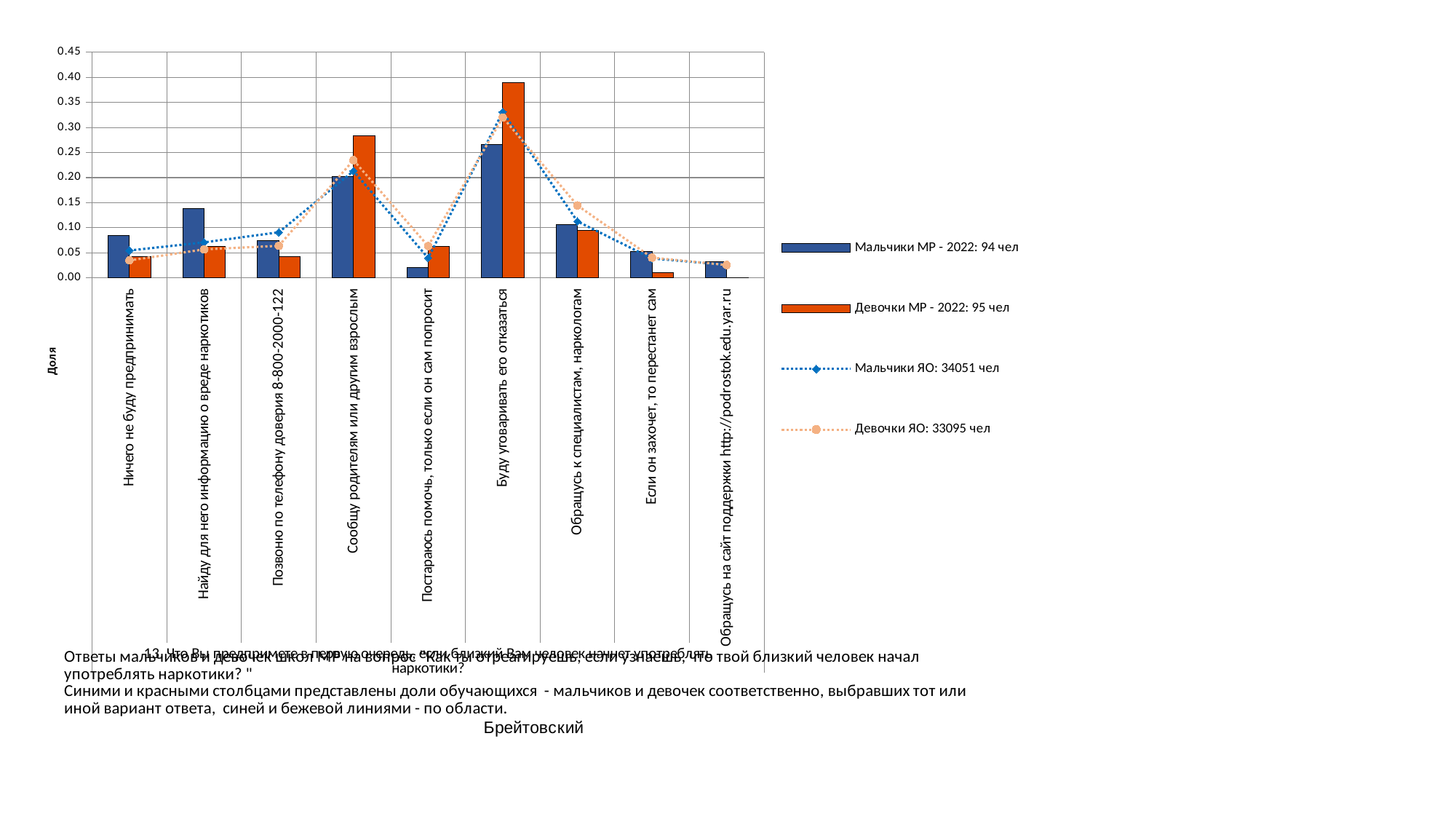
For 'Сообщу родителям или другим взрослым', which is larger: the Мальчики МР - 2022 bar or the Девочки МР - 2022 bar? Девочки МР - 2022 Is the Девочки МР - 2022 value for 'Ничего не буду предпринимать' greater or less than 0.05? less How many answer categories are shown on the x axis of the chart? 9 Is the Девочки МР - 2022 value for 'Буду уговаривать его отказаться' greater or less than 0.35? greater How many respondents does the legend give for the Мальчики ЯО series? 34051 чел Is the Мальчики МР - 2022 value for 'Найду для него информацию о вреде наркотиков' greater or less than 0.10? greater How many series does the chart legend list? 4 Which category has the highest value for the Мальчики МР - 2022 series? Буду уговаривать его отказаться What kind of chart is used to plot the Мальчики МР - 2022 and Девочки МР - 2022 series? bar chart Which category has the lowest value for the Мальчики МР - 2022 series? Постараюсь помочь, только если он сам попросит Which category has the highest value for the Девочки МР - 2022 series? Буду уговаривать его отказаться For 'Ничего не буду предпринимать', which is larger: the Мальчики МР - 2022 bar or the Девочки МР - 2022 bar? Мальчики МР - 2022